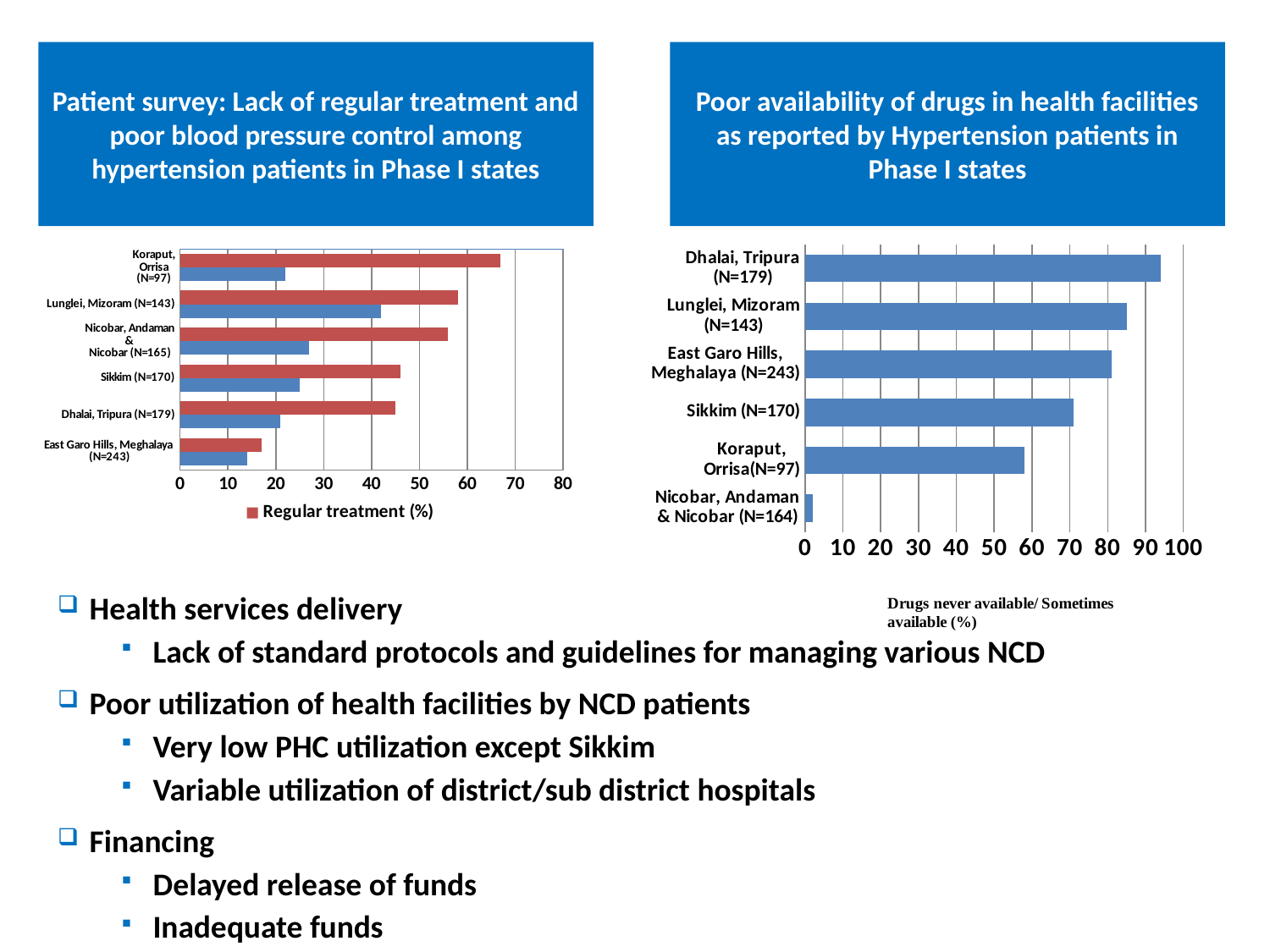
What kind of chart is the left chart titled 'Patient survey: Lack of regular treatment and poor blood pressure control among hypertension patients in Phase I states'? Bar chart In the right chart on drug availability, which category has the lowest value? Nicobar, Andaman & Nicobar (N=164) In the right chart on drug availability, how many states/districts are plotted? 6 What kind of chart is the right chart titled 'Poor availability of drugs in health facilities as reported by Hypertension patients in Phase I states'? Bar chart In the right chart on drug availability, is the value for Nicobar, Andaman & Nicobar greater or less than 10? less In the right chart on drug availability, is the value for Dhalai, Tripura greater or less than 90? greater In the left chart, which category has the highest Regular treatment (%) value (red bar)? Koraput, Orrisa (N=97) In the left chart, which series name is shown in the legend? Regular treatment (%) In the left chart on regular treatment, how many categories are shown on the vertical axis? 6 In the right chart on drug availability, which category has the highest value? Dhalai, Tripura (N=179) In the left chart, which category has the lowest Regular treatment (%) value (red bar)? East Garo Hills, Meghalaya (N=243) In the left chart, is the Regular treatment (%) value for Koraput, Orrisa greater or less than 60? greater